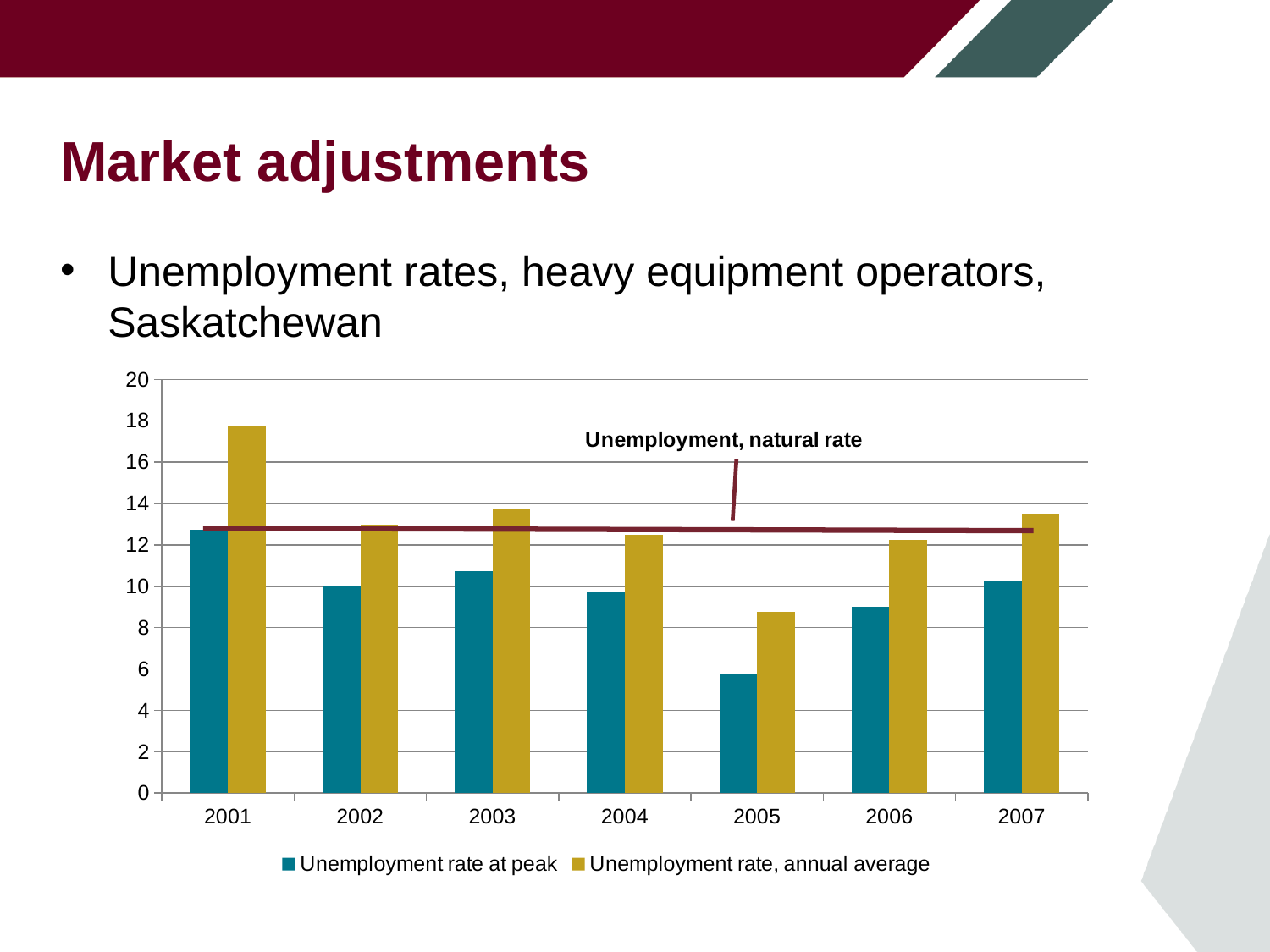
Is the unemployment rate, annual average, for 2003 greater or less than 12? greater What kind of chart is shown on the slide? Bar chart Is the unemployment rate, annual average, for 2001 greater or less than 16? greater In which year is the unemployment rate, annual average, highest? 2001 How many series does the chart legend list? 2 In which year is the unemployment rate at peak lowest? 2005 In which year is the unemployment rate at peak highest? 2001 How many years are shown on the x axis of the chart? 7 In which year is the unemployment rate, annual average, lowest? 2005 Is the unemployment rate at peak for 2005 greater or less than 8? less Which is larger: the unemployment rate, annual average, in 2001 or in 2007? 2001 What does the horizontal line across the chart represent? Unemployment, natural rate